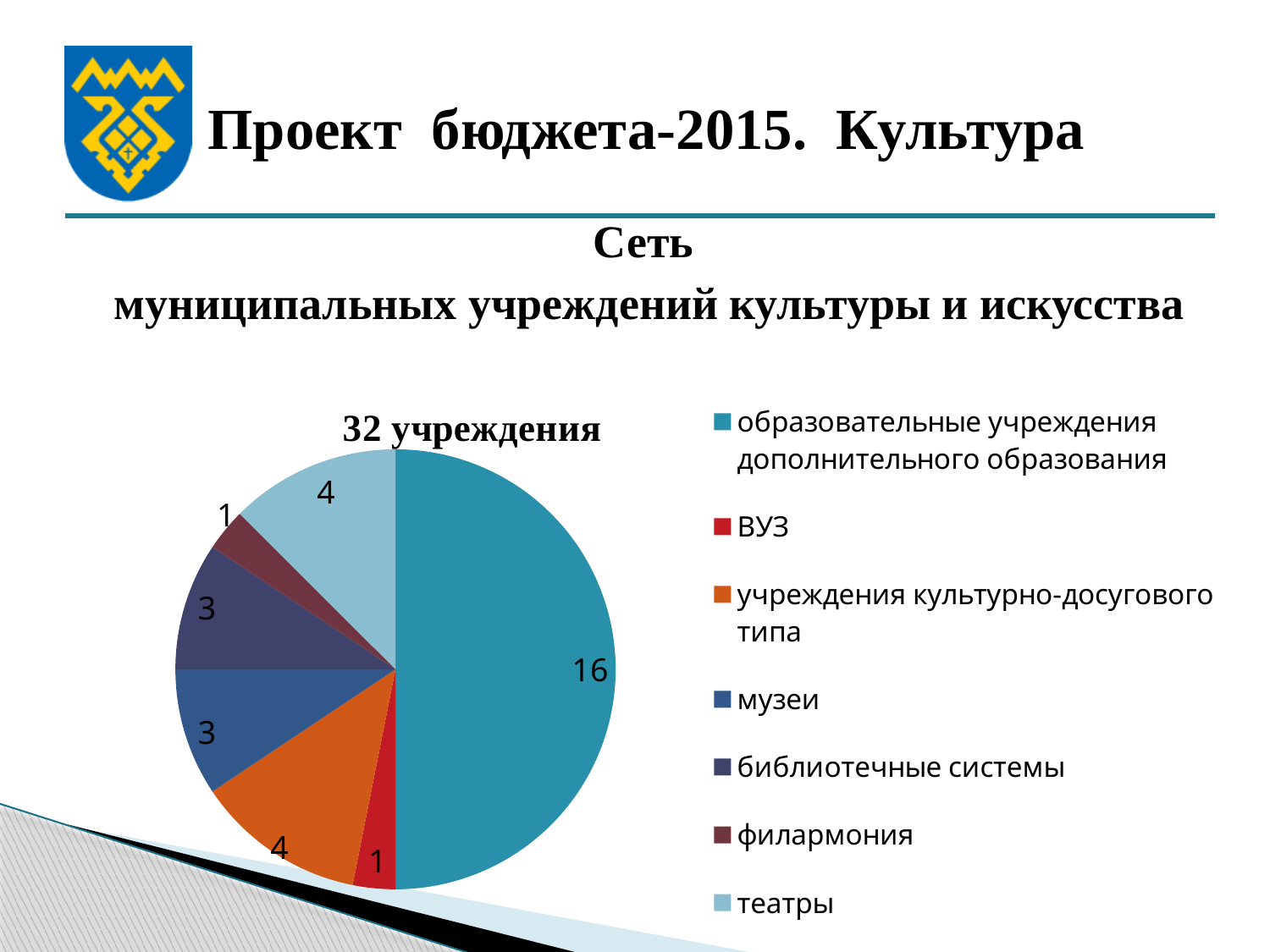
How many categories does the legend of the pie chart list? 7 What is the value for филармония? 1 What is the value for музеи? 3 What share of the pie does the slice for образовательные учреждения дополнительного образования represent? 50% What is the title of the pie chart? 32 учреждения What is the difference between the value for образовательные учреждения дополнительного образования and the value for театры? 12 Which category has the largest slice of the pie? образовательные учреждения дополнительного образования What is the value for учреждения культурно-досугового типа? 4 What kind of chart is shown on the slide? pie chart What is the value for образовательные учреждения дополнительного образования? 16 Which is larger, the value for учреждения культурно-досугового типа or the value for библиотечные системы? учреждения культурно-досугового типа What is the total number of institutions shown in the pie chart? 32